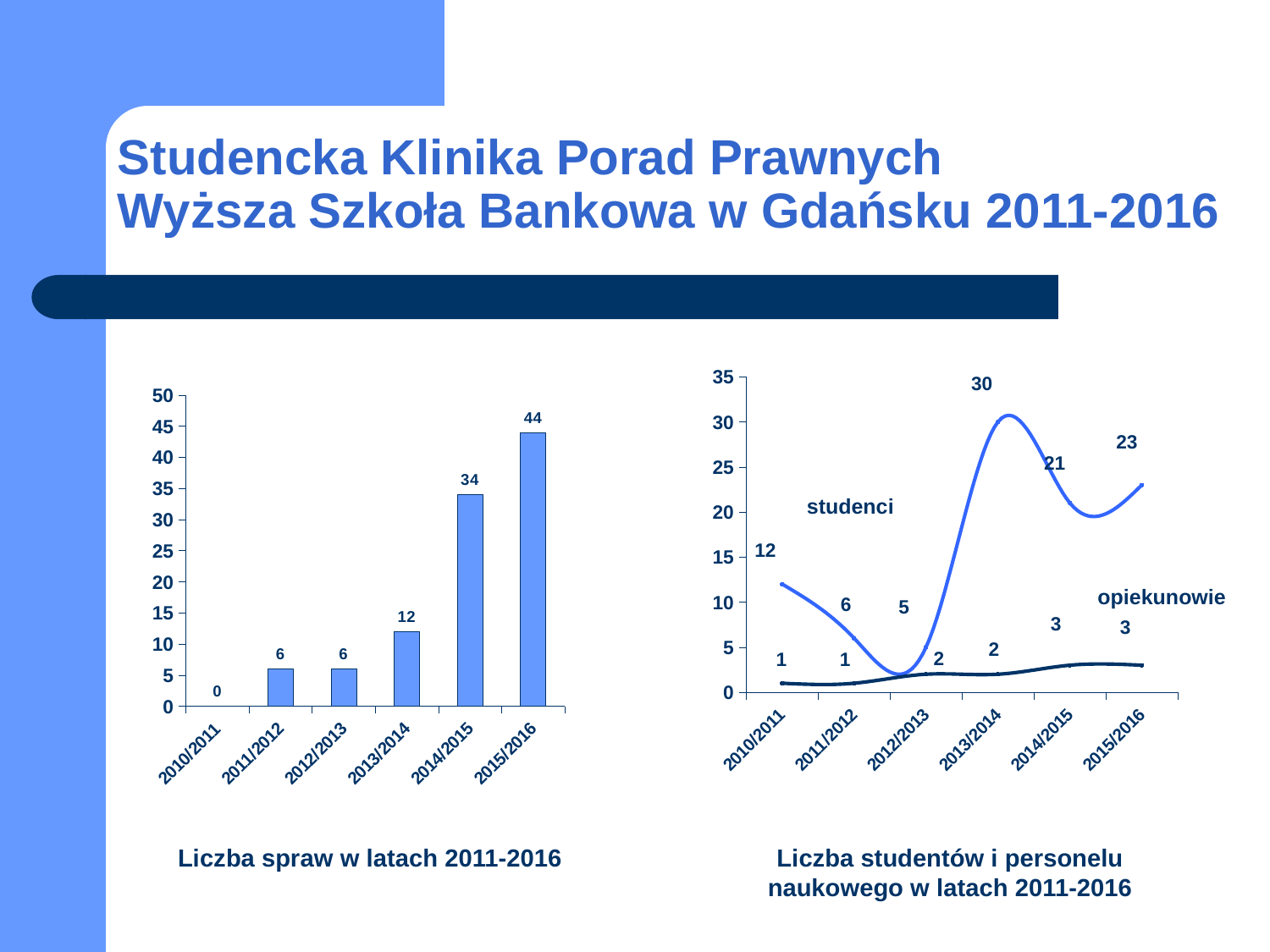
What kind of chart is the left chart (Liczba spraw w latach 2011-2016)? bar chart In the right chart (Liczba studentów i personelu naukowego w latach 2011-2016), what is the value for opiekunowie in 2015/2016? 3 What kind of chart is the right chart (Liczba studentów i personelu naukowego w latach 2011-2016)? line chart In the left chart (Liczba spraw w latach 2011-2016), which year has the highest value? 2015/2016 In the right chart (Liczba studentów i personelu naukowego w latach 2011-2016), what is the value for studenci in 2013/2014? 30 In the right chart (Liczba studentów i personelu naukowego w latach 2011-2016), which is larger: studenci in 2014/2015 or studenci in 2015/2016? studenci in 2015/2016 In the left chart (Liczba spraw w latach 2011-2016), what is the difference between the values for 2015/2016 and 2014/2015? 10 In the left chart (Liczba spraw w latach 2011-2016), how many years are shown on the x axis? 6 In the right chart (Liczba studentów i personelu naukowego w latach 2011-2016), what is the difference between studenci and opiekunowie in 2013/2014? 28 In the left chart (Liczba spraw w latach 2011-2016), which year has the lowest value? 2010/2011 In the left chart (Liczba spraw w latach 2011-2016), what is the value for 2014/2015? 34 In the right chart (Liczba studentów i personelu naukowego w latach 2011-2016), in which year is the studenci value lowest? 2012/2013